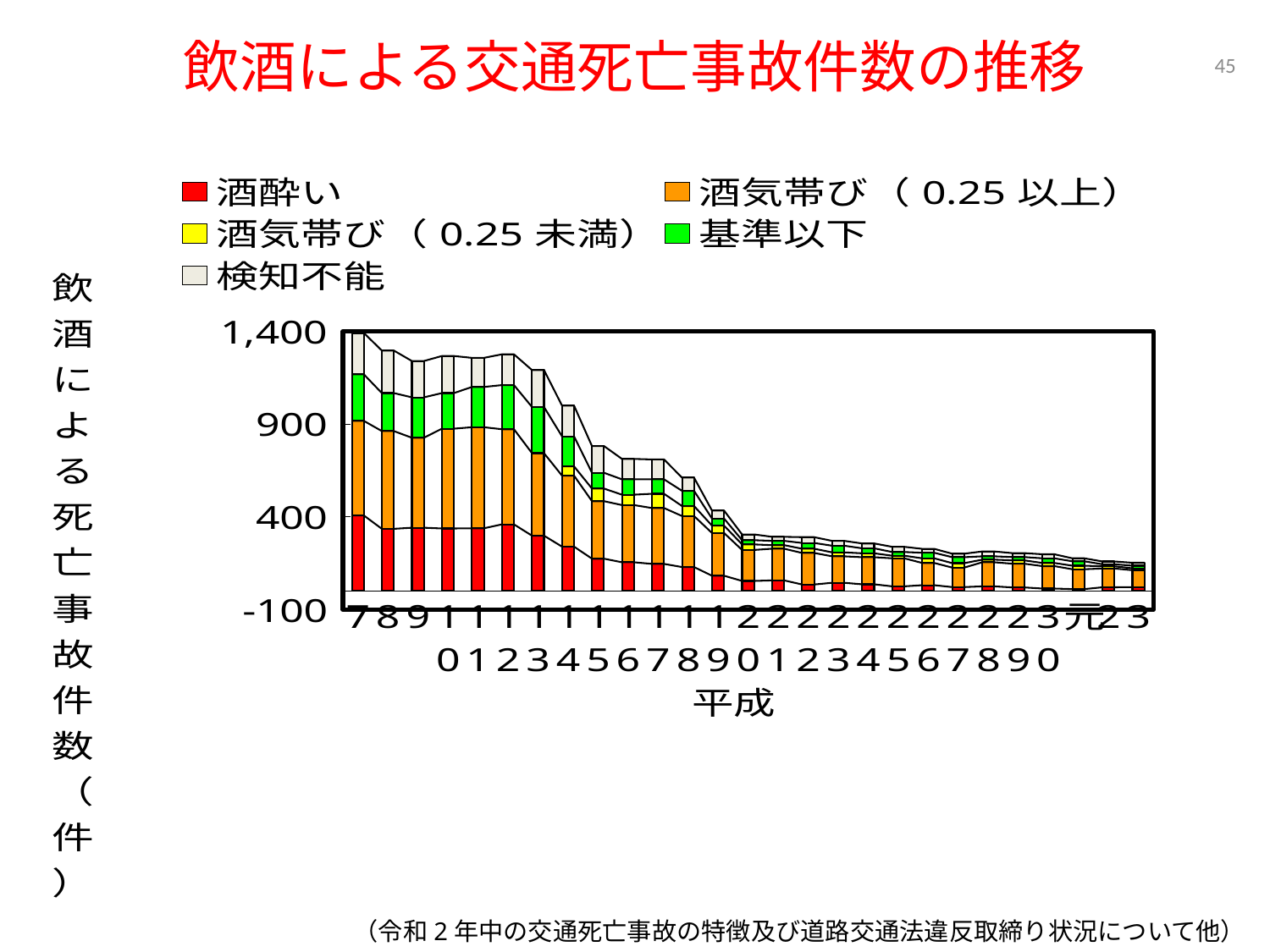
Which has the larger total bar, 平成7 or 令和3? 平成7 Is the total for 平成20 greater or less than 900? less Which legend entry is shown in red? 酒酔い What is the title of the chart on the slide? 飲酒による交通死亡事故件数の推移 Is the total for 令和3 greater or less than 400? less Which year has the highest total bar? 平成7 How many bars (years) are plotted in the chart? 27 Do the total bar heights generally rise or fall from left to right along the x axis? fall Is the total for 平成15 greater or less than 900? less What kind of chart is shown on the slide? stacked bar chart How many series does the legend list? 5